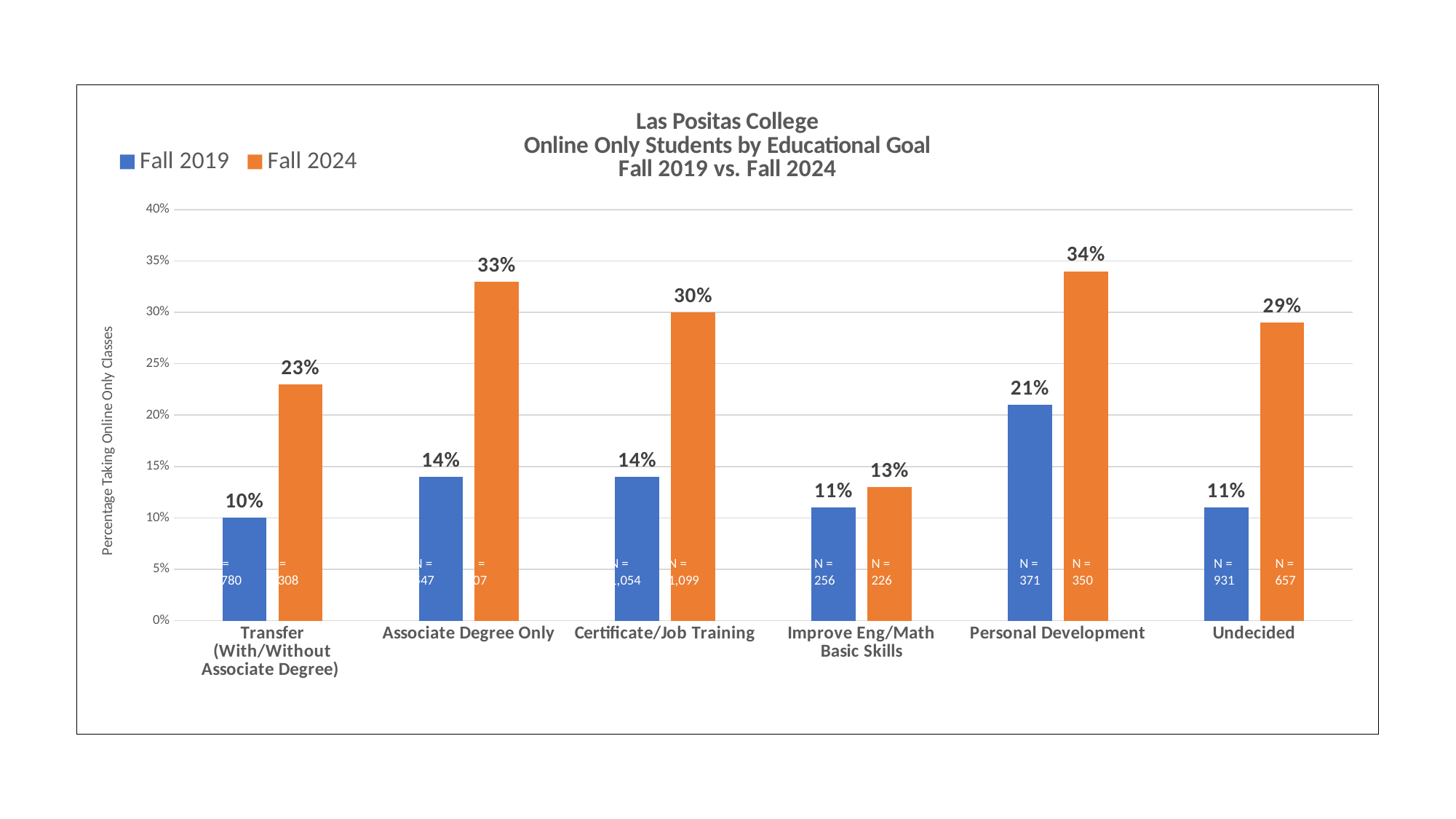
Which category has the lowest Fall 2019 value? Transfer (With/Without Associate Degree) What is the difference between the Fall 2024 and Fall 2019 values for Associate Degree Only? 19 percentage points What is the Fall 2024 value for Improve Eng/Math Basic Skills? 13% What is the Fall 2019 value for Transfer (With/Without Associate Degree)? 10% How many educational goal categories are shown on the x axis? 6 Is the Fall 2024 value for Certificate/Job Training greater or less than 25%? greater How many series does the legend list? 2 What is the label of the vertical axis? Percentage Taking Online Only Classes Which category has the highest Fall 2024 value? Personal Development What kind of chart is shown on the slide? Bar chart Which is larger for Undecided: the Fall 2019 value or the Fall 2024 value? Fall 2024 What is the Fall 2024 value for Personal Development? 34%